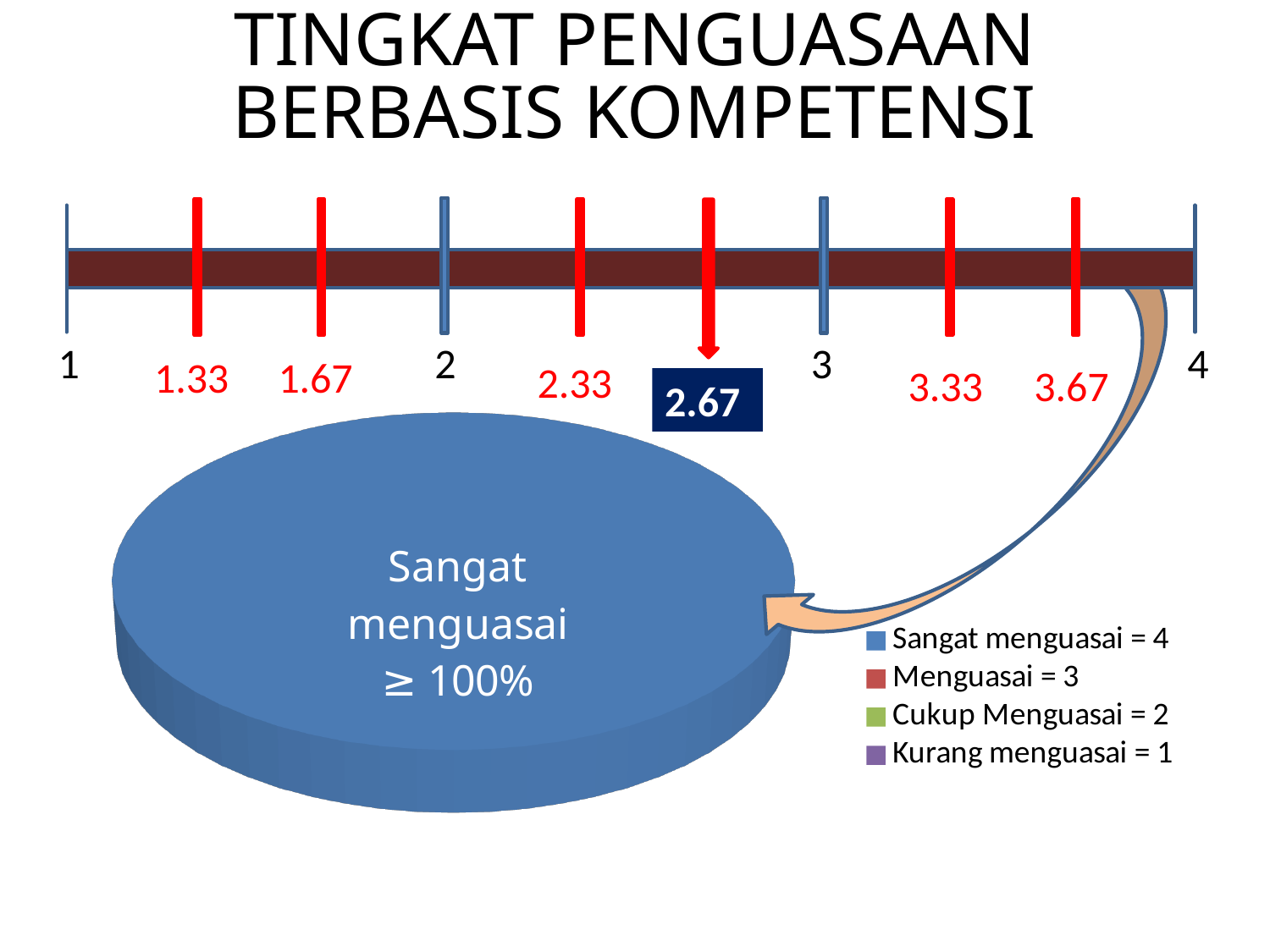
What kind of chart is shown on the slide? pie chart According to the legend, what score corresponds to 'Cukup Menguasai'? 2 According to the legend, what score corresponds to 'Menguasai'? 3 How many slices are visible in the pie chart? 1 What value is highlighted in the dark box below the scale at the top of the slide? 2.67 What colour is the 'Sangat menguasai' slice in the pie chart? blue What share of the pie is labelled for the 'Sangat menguasai' slice? ≥ 100% According to the legend, what score corresponds to 'Kurang menguasai'? 1 Which category is the only slice shown in the pie chart? Sangat menguasai How many entries does the legend of the pie chart list? 4 According to the legend, what score corresponds to 'Sangat menguasai'? 4